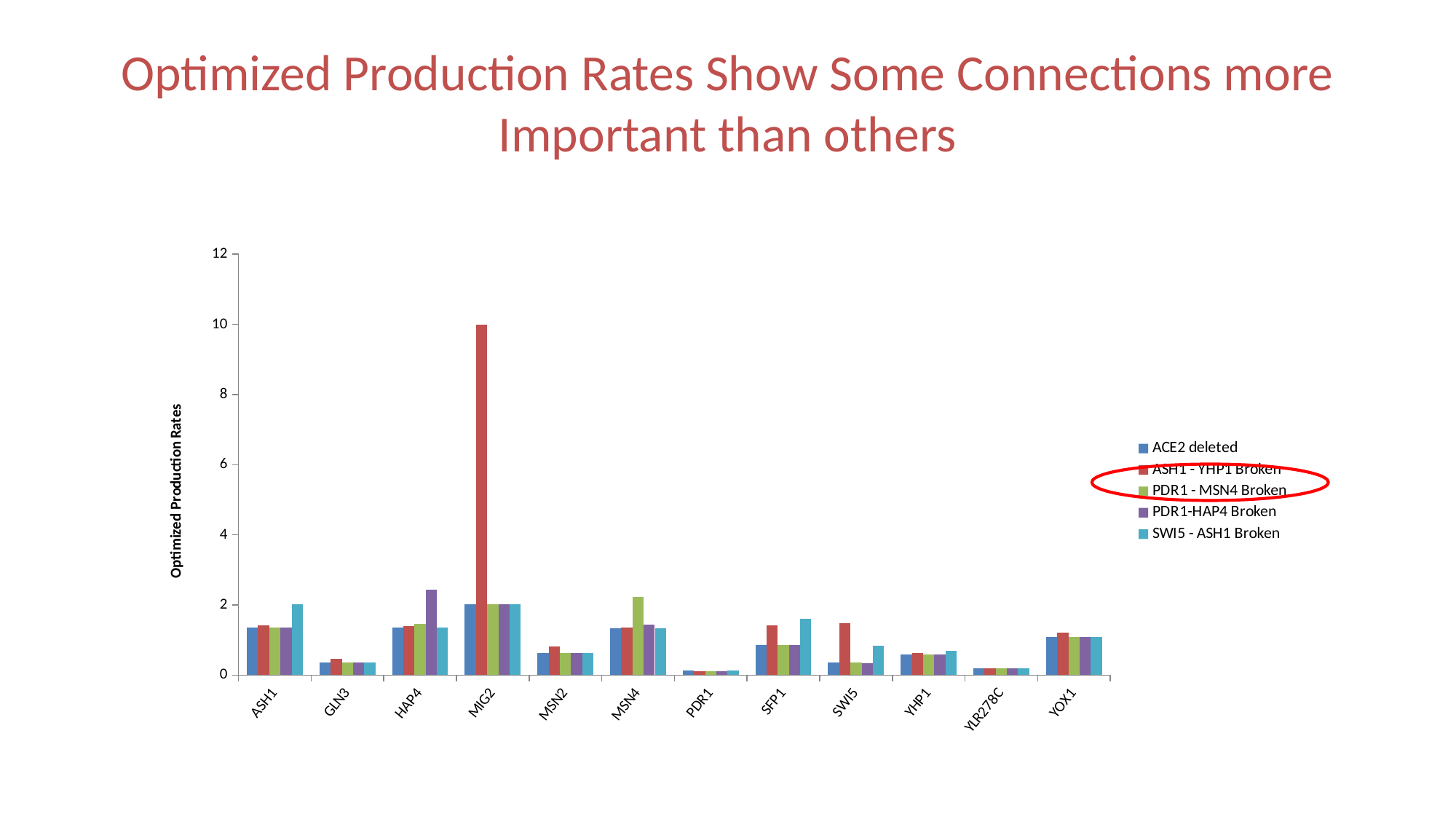
Which series has the tallest bar for MIG2? ASH1 - YHP1 Broken Is the value for ASH1 - YHP1 Broken at MIG2 greater or less than 8? greater Which category has the tallest bar in the chart? MIG2 What is the label of the y axis of the chart? Optimized Production Rates Which category has the lowest bars overall in the chart? PDR1 Is the value for ACE2 deleted at ASH1 greater or less than 2? less Is the value for PDR1-HAP4 Broken at HAP4 greater or less than 2? greater Which is larger at SWI5: the ASH1 - YHP1 Broken bar or the ACE2 deleted bar? ASH1 - YHP1 Broken How many series does the chart's legend list? 5 What kind of chart is shown on the slide? bar chart How many categories are shown along the x axis of the chart? 12